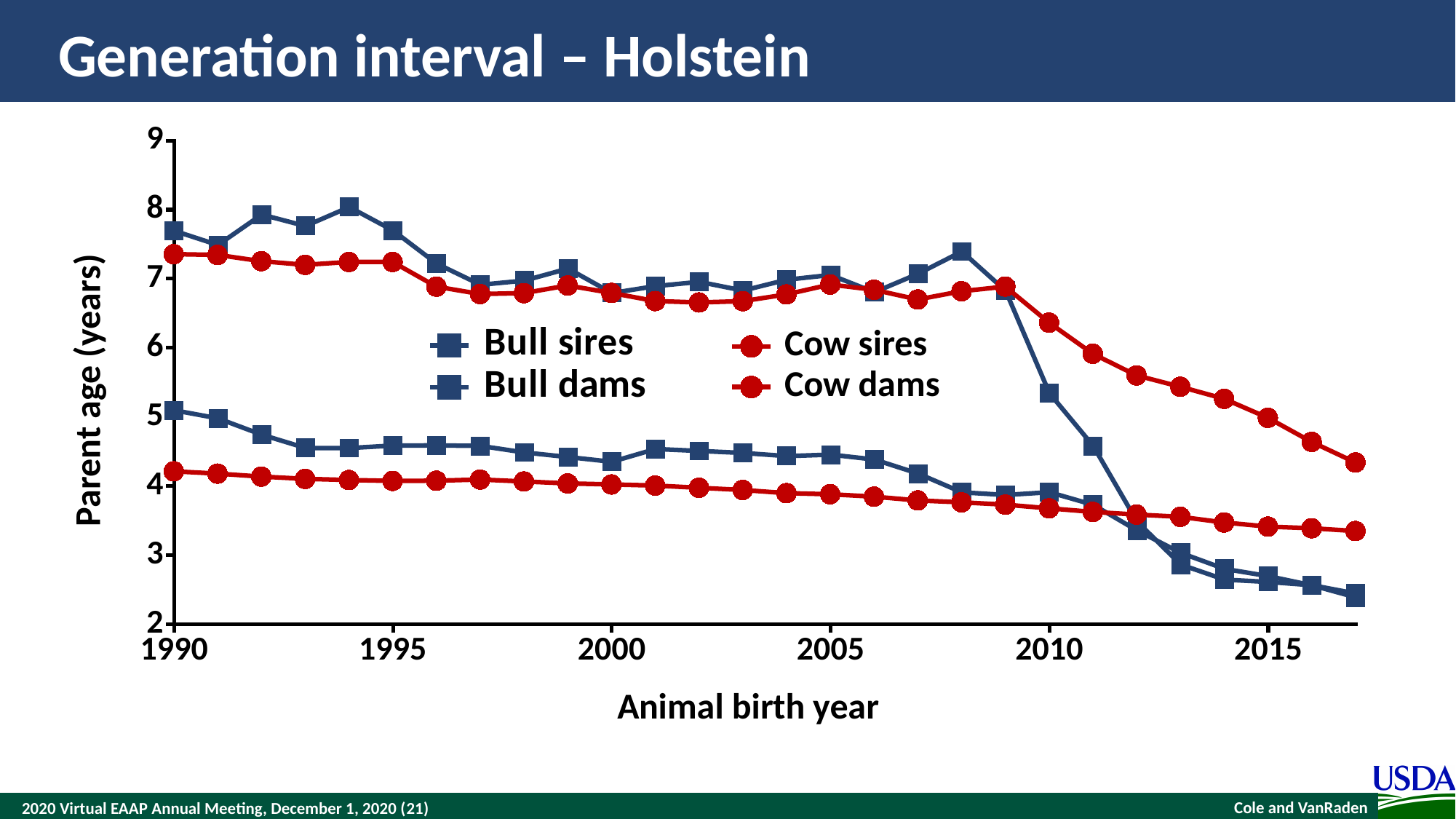
Is the value for Bull sires in 2017 greater or less than 3? less In 1990, which is higher: Bull dams or Cow dams? Bull dams What kind of chart is shown on the slide? Line chart What is the label of the y axis? Parent age (years) Which series has the highest value in 1990? Bull sires Is the value for Bull sires in 1994 greater or less than 7? greater Is the value for Cow dams in 2017 greater or less than 4? less How many series does the legend list? 4 In 2017, which is higher: Cow sires or Bull sires? Cow sires What are the four series named in the legend? Bull sires, Bull dams, Cow sires, Cow dams